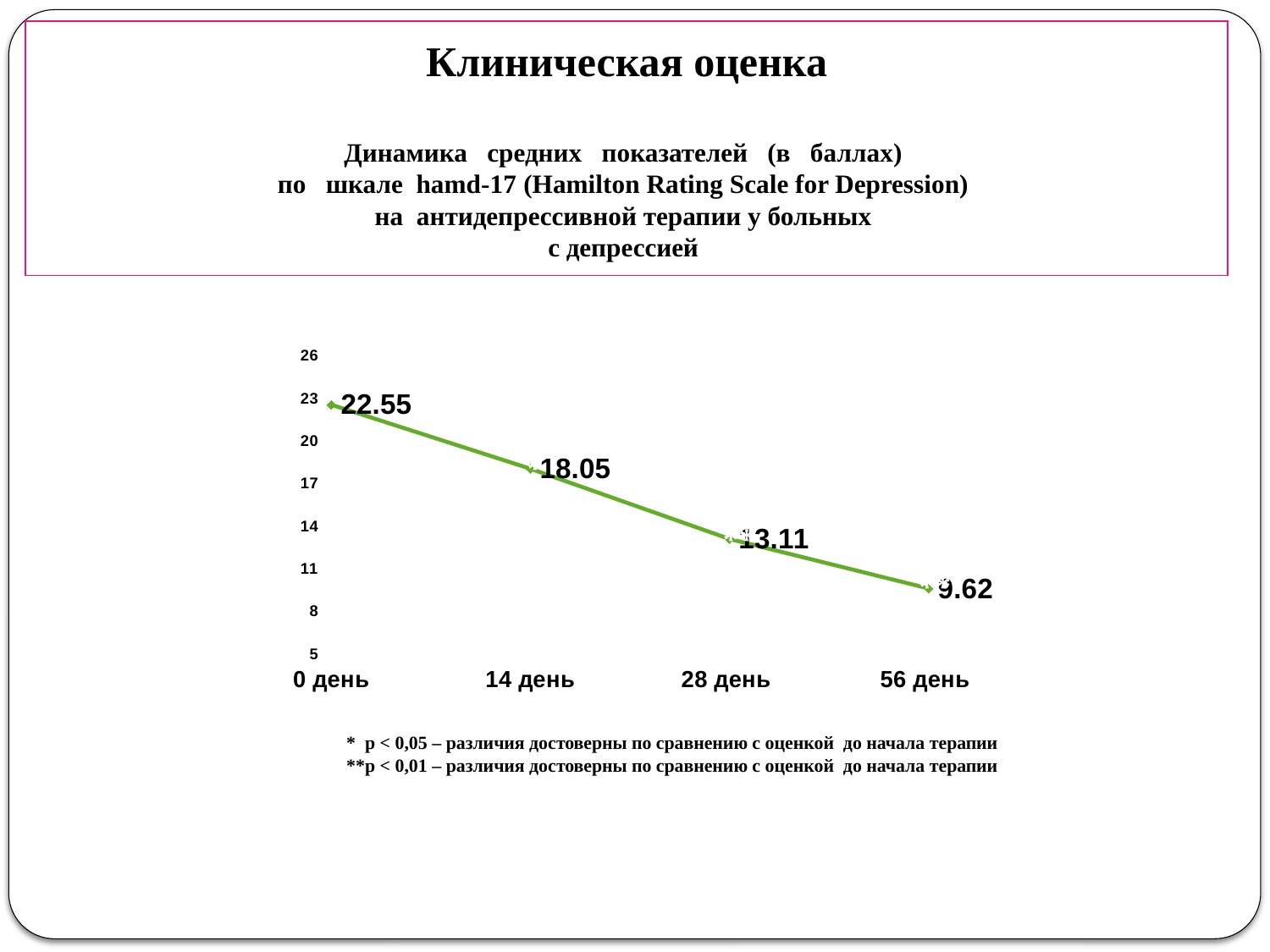
At which time point is the HAMD-17 score lowest? 56 день How many time points are plotted on the chart? 4 What is the HAMD-17 score at 14 день? 18.05 What is the difference between the scores at 0 день and 56 день? 12.93 What is the HAMD-17 score at 0 день? 22.55 What kind of chart is shown on the slide? line chart What is the difference between the scores at 14 день and 28 день? 4.94 What is the HAMD-17 score at 56 день? 9.62 Do the HAMD-17 scores rise or fall from 0 день to 56 день? fall What is the HAMD-17 score at 28 день? 13.11 Which is larger, the score at 14 день or at 28 день? 14 день At which time point is the HAMD-17 score highest? 0 день